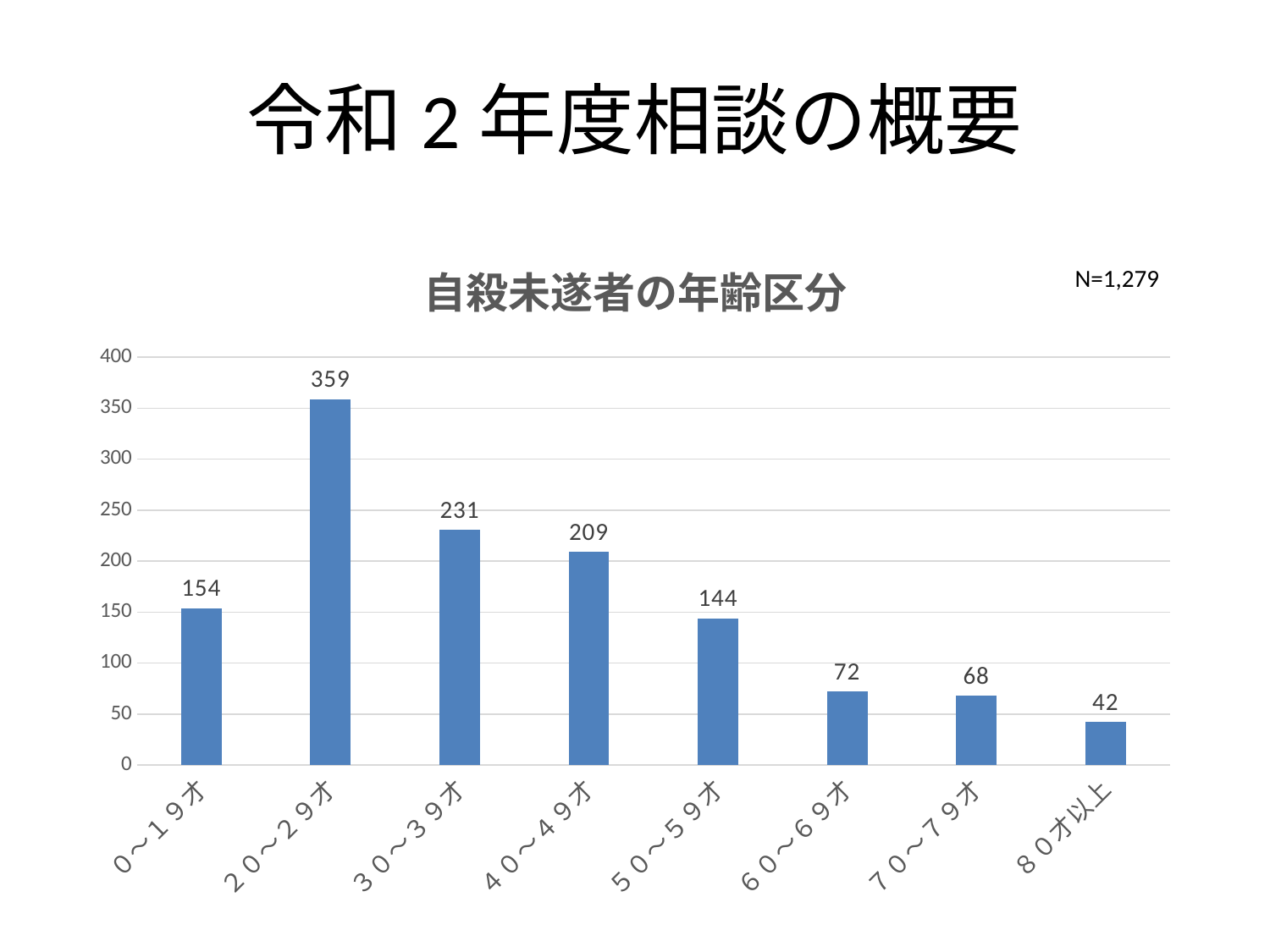
What kind of chart is shown on the slide? Bar chart What is the value for the 20～29才 age group? 359 Which is larger, the value for 30～39才 or the value for 40～49才? 30～39才 What is the difference between the values for 0～19才 and 50～59才? 10 What is the difference between the values for 20～29才 and 30～39才? 128 Which age group has the highest value? 20～29才 How many age groups are shown on the x axis? 8 What is the title of the chart? 自殺未遂者の年齢区分 Do the values rise or fall from 20～29才 to 80才以上? Fall What is the value for the 80才以上 age group? 42 Which age group has the lowest value? 80才以上 What is the value for the 50～59才 age group? 144